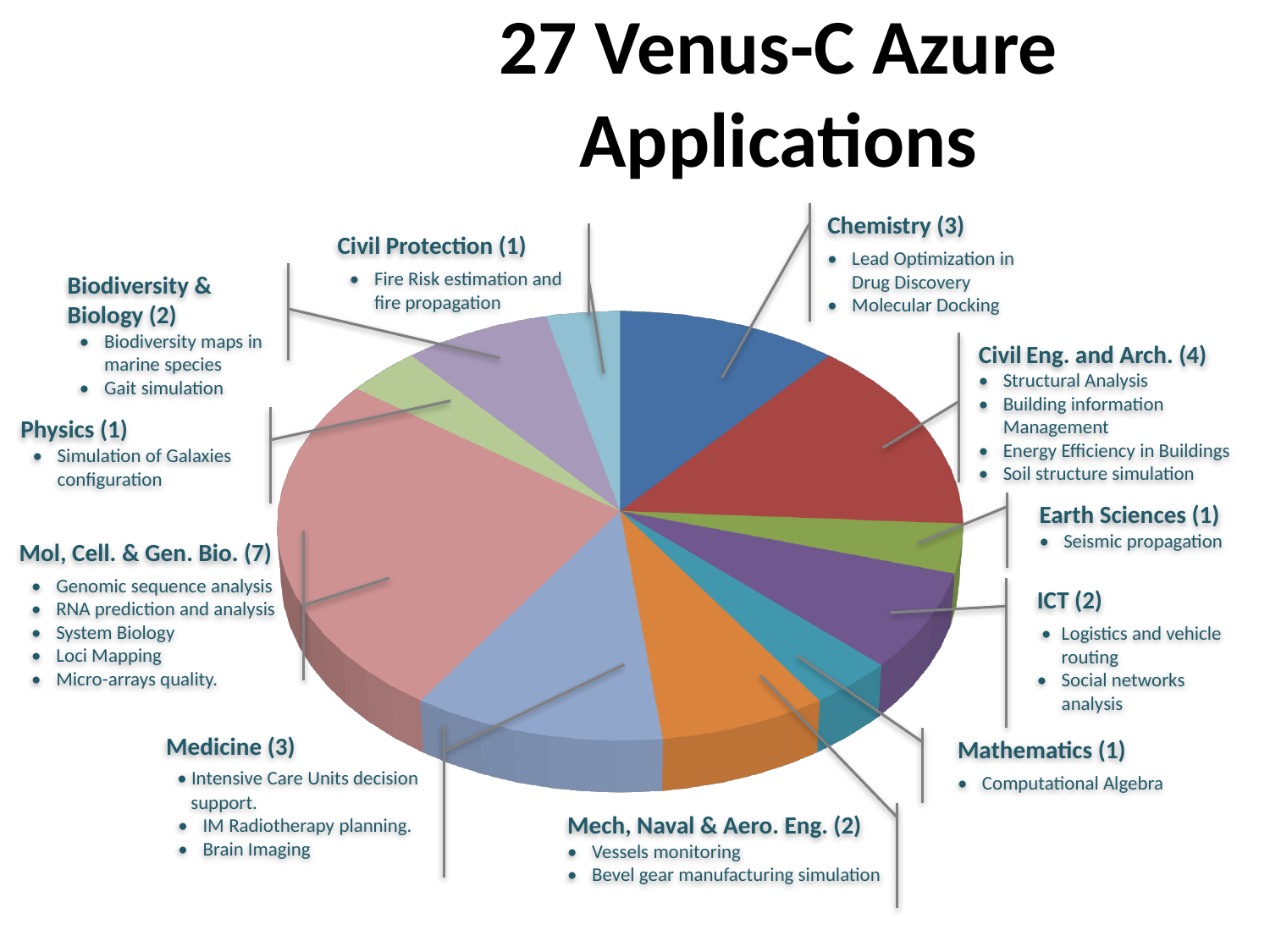
How many applications are in the Civil Eng. and Arch. category? 4 What is the total number of applications shown in the chart, according to the slide title? 27 Which category has the largest number of applications in the pie chart? Mol, Cell. & Gen. Bio. (7) How many applications are in the ICT category? 2 How many more applications does Mol, Cell. & Gen. Bio. have than Civil Eng. and Arch.? 3 What is the difference between the number of applications in Civil Eng. and Arch. and in Chemistry? 1 What kind of chart is shown on the slide? pie chart How many applications are in the Chemistry category? 3 Which has more applications, Medicine or ICT? Medicine How many categories (slices) does the pie chart have? 11 How many applications are in the Mech, Naval & Aero. Eng. category? 2 How many categories have exactly 1 application? 4